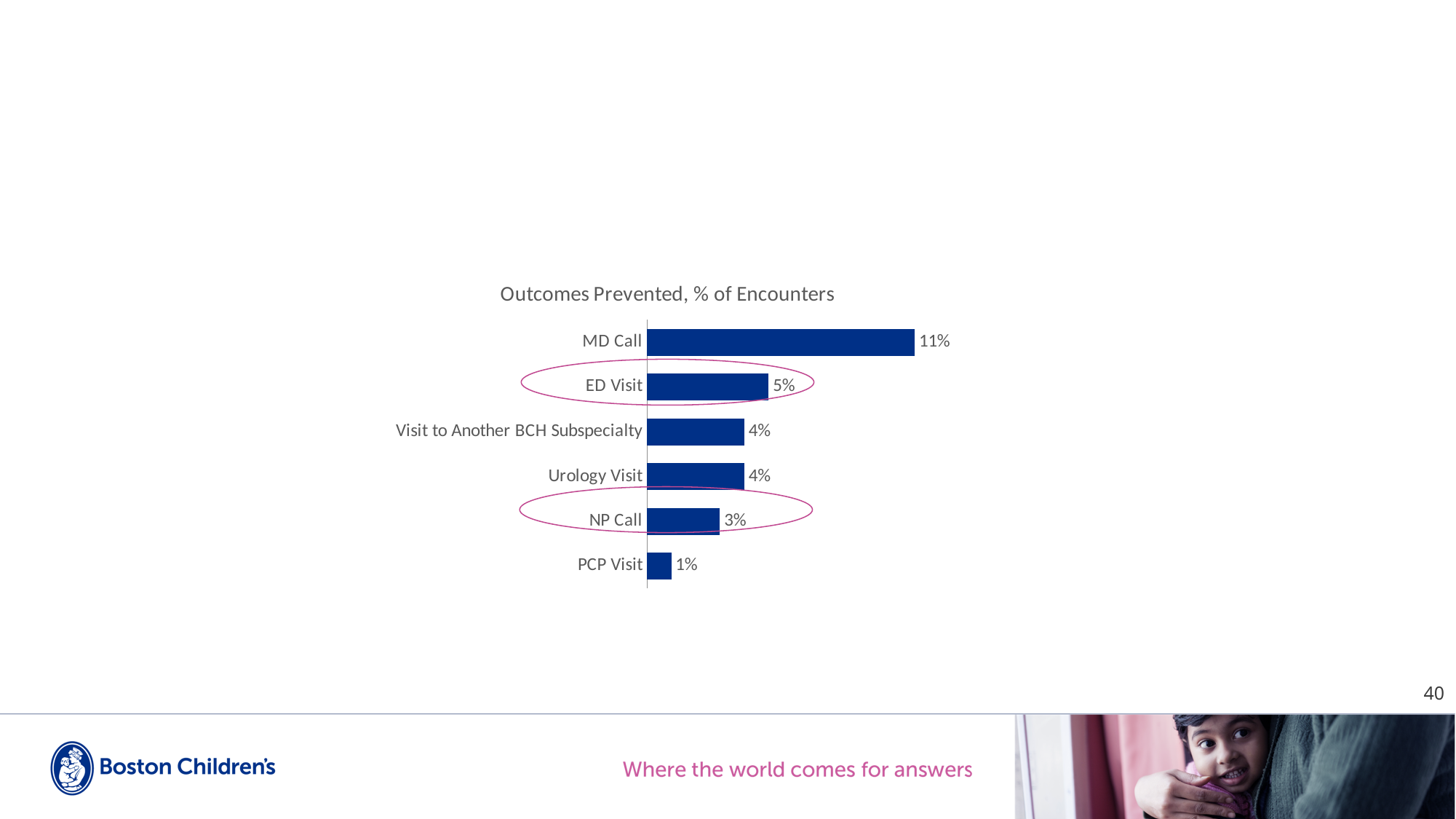
What is the value for ED Visit? 5% What is the value for MD Call? 11% Which category has the highest value? MD Call How many categories are shown in the chart? 6 Which is larger, the value for ED Visit or the value for NP Call? ED Visit What kind of chart is shown on the slide? Bar chart What is the value for NP Call? 3% What is the value for PCP Visit? 1% What is the value for Visit to Another BCH Subspecialty? 4% What is the difference between the values for MD Call and ED Visit? 6% What is the title of the chart? Outcomes Prevented, % of Encounters Which category has the lowest value? PCP Visit